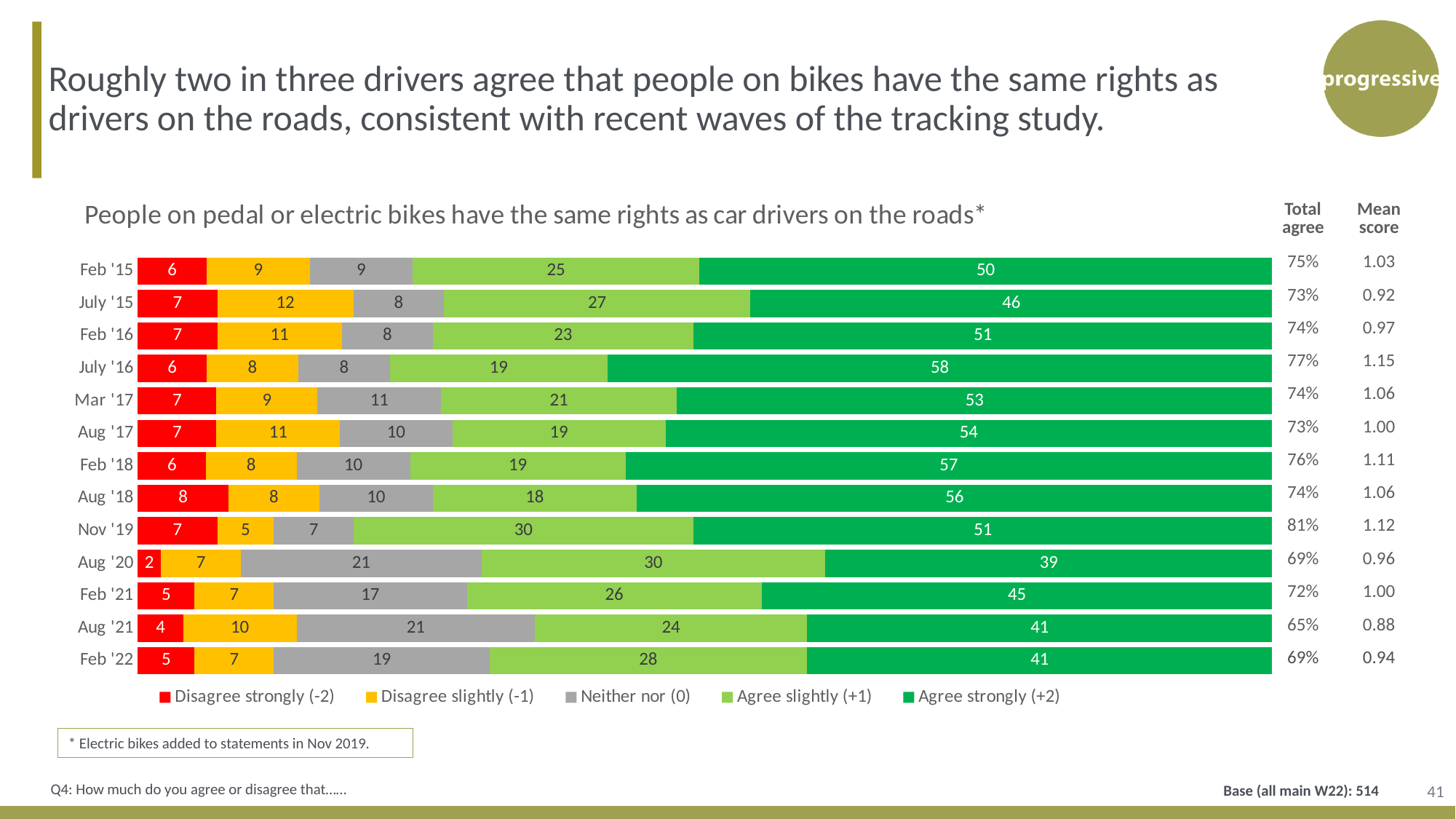
In which wave is the 'Agree strongly (+2)' value highest? July '16 What is the difference between the 'Agree slightly (+1)' values for Nov '19 and Aug '18? 12 How many series does the legend list? 5 What kind of chart is shown on the slide? Stacked bar chart Which wave has the larger 'Disagree slightly (-1)' value, July '15 or Feb '21? July '15 What percentage of drivers agreed strongly in Feb '22? 41 What is the Total agree figure for Nov '19? 81% What is the 'Neither nor (0)' value for Aug '20? 21 What is the Mean score for Aug '21? 0.88 In which wave is the 'Agree strongly (+2)' value lowest? Aug '20 What is the total of the stacked bar for Feb '22? 100 How many survey waves are shown in the chart? 13